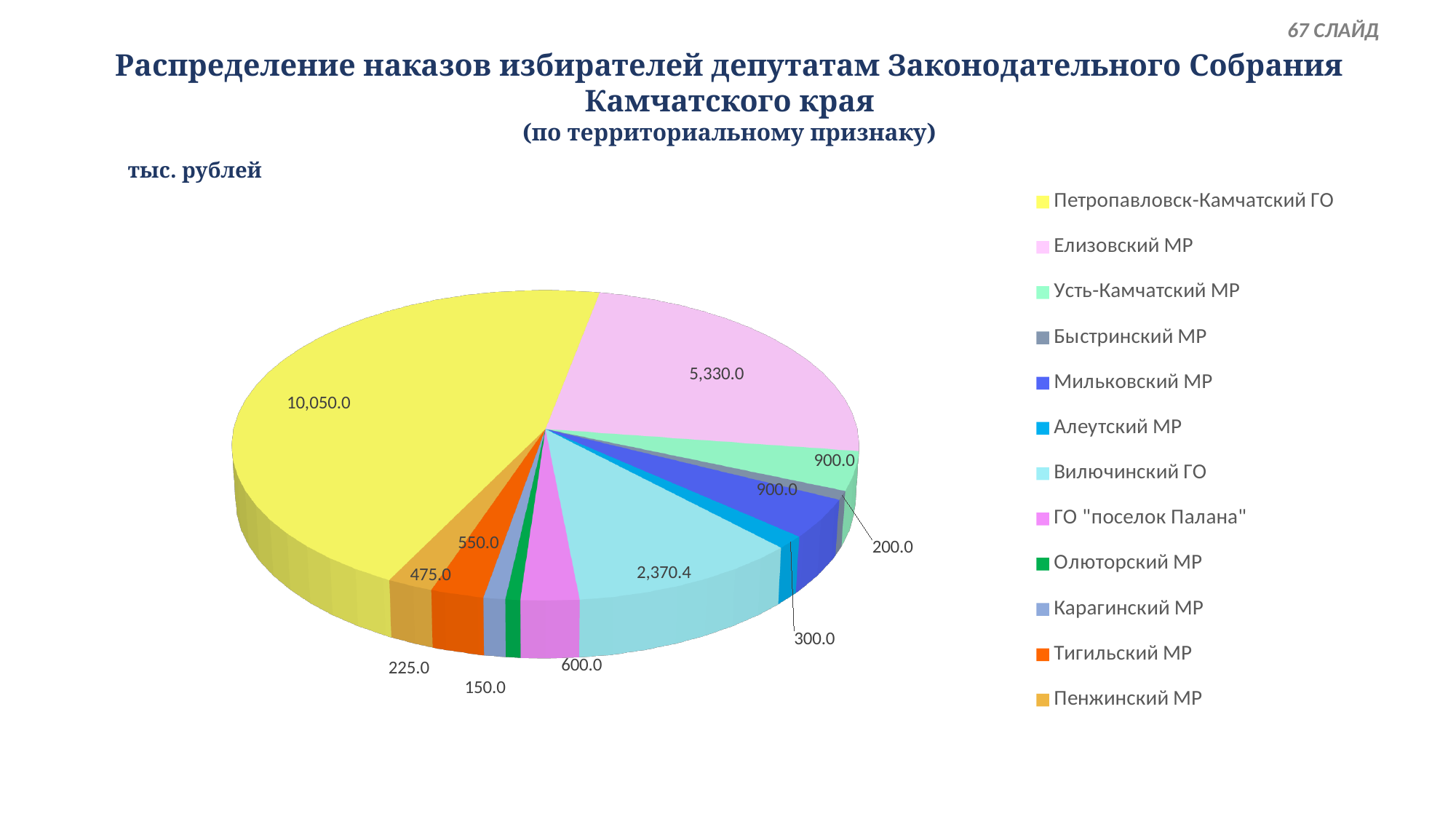
How many categories does the pie chart show? 12 Which category has the smallest slice of the pie? Олюторский МР Which category has the largest slice of the pie? Петропавловск-Камчатский ГО What is the value for Быстринский МР? 200.0 What is the value for Вилючинский ГО? 2,370.4 What unit is stated for the values in the chart? тыс. рублей What is the value for Елизовский МР? 5,330.0 What is the value for Петропавловск-Камчатский ГО? 10,050.0 Which is larger, the value for Пенжинский МР or the value for Тигильский МР? Тигильский МР What is the difference between the values for Петропавловск-Камчатский ГО and Елизовский МР? 4,720.0 What kind of chart is shown on the slide? pie chart What is the value for Тигильский МР? 550.0